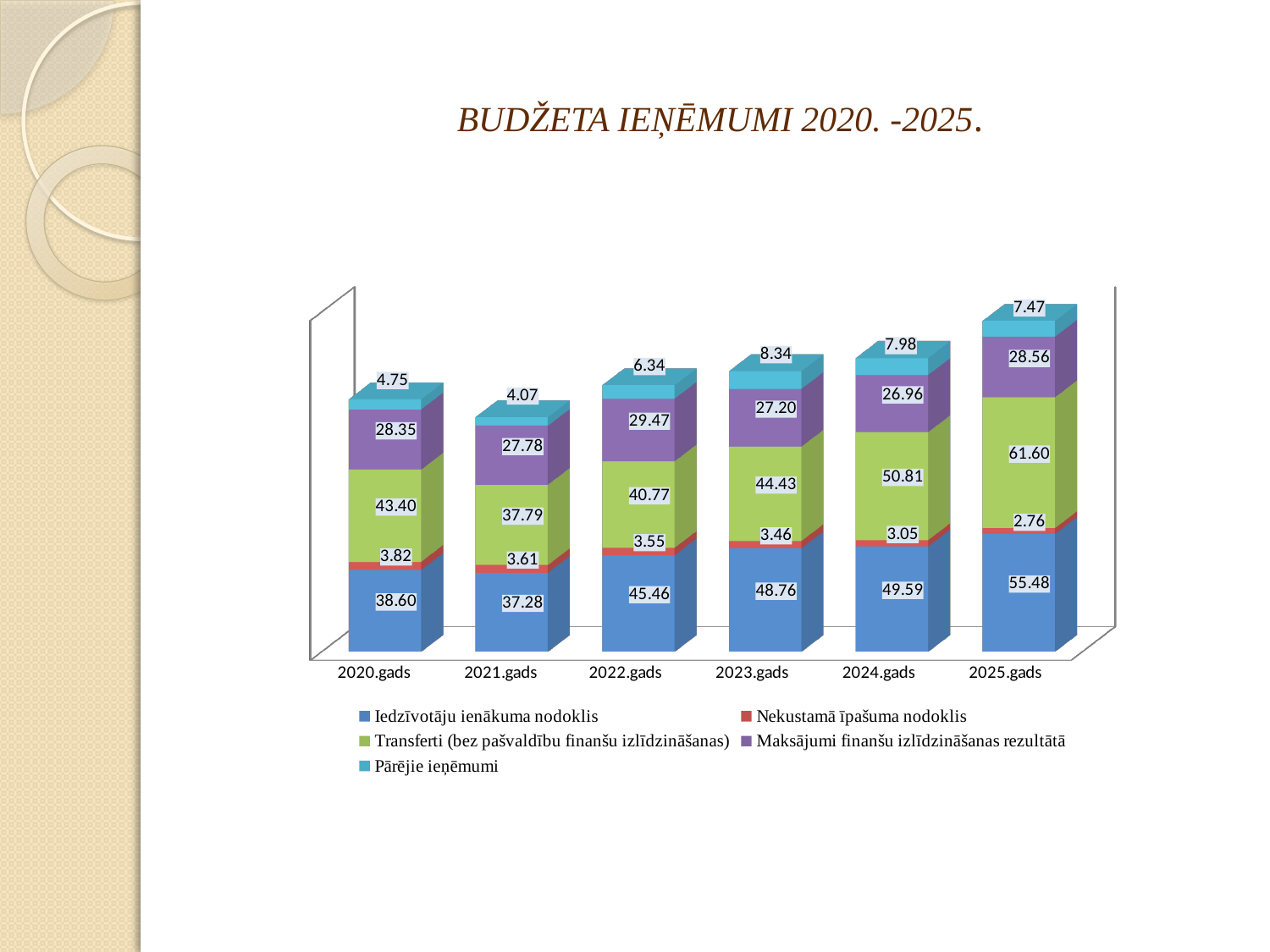
What is the value of Pārējie ieņēmumi for 2023.gads? 8.34 Does the value of Nekustamā īpašuma nodoklis rise or fall from 2020.gads to 2025.gads? Fall What is the difference between the Transferti values for 2025.gads and 2024.gads? 10.79 What is the total of the stacked bar for 2020.gads? 118.92 How many series does the legend list? 5 What is the value of Transferti (bez pašvaldību finanšu izlīdzināšanas) for 2021.gads? 37.79 How many years (categories) are shown on the x axis? 6 What kind of chart is shown on the slide? Stacked bar chart What is the value of Iedzīvotāju ienākuma nodoklis for 2025.gads? 55.48 Which year has the lowest value for Pārējie ieņēmumi? 2021.gads Which year has the highest value for Iedzīvotāju ienākuma nodoklis? 2025.gads Which is larger: Maksājumi finanšu izlīdzināšanas rezultātā in 2022.gads or in 2023.gads? 2022.gads